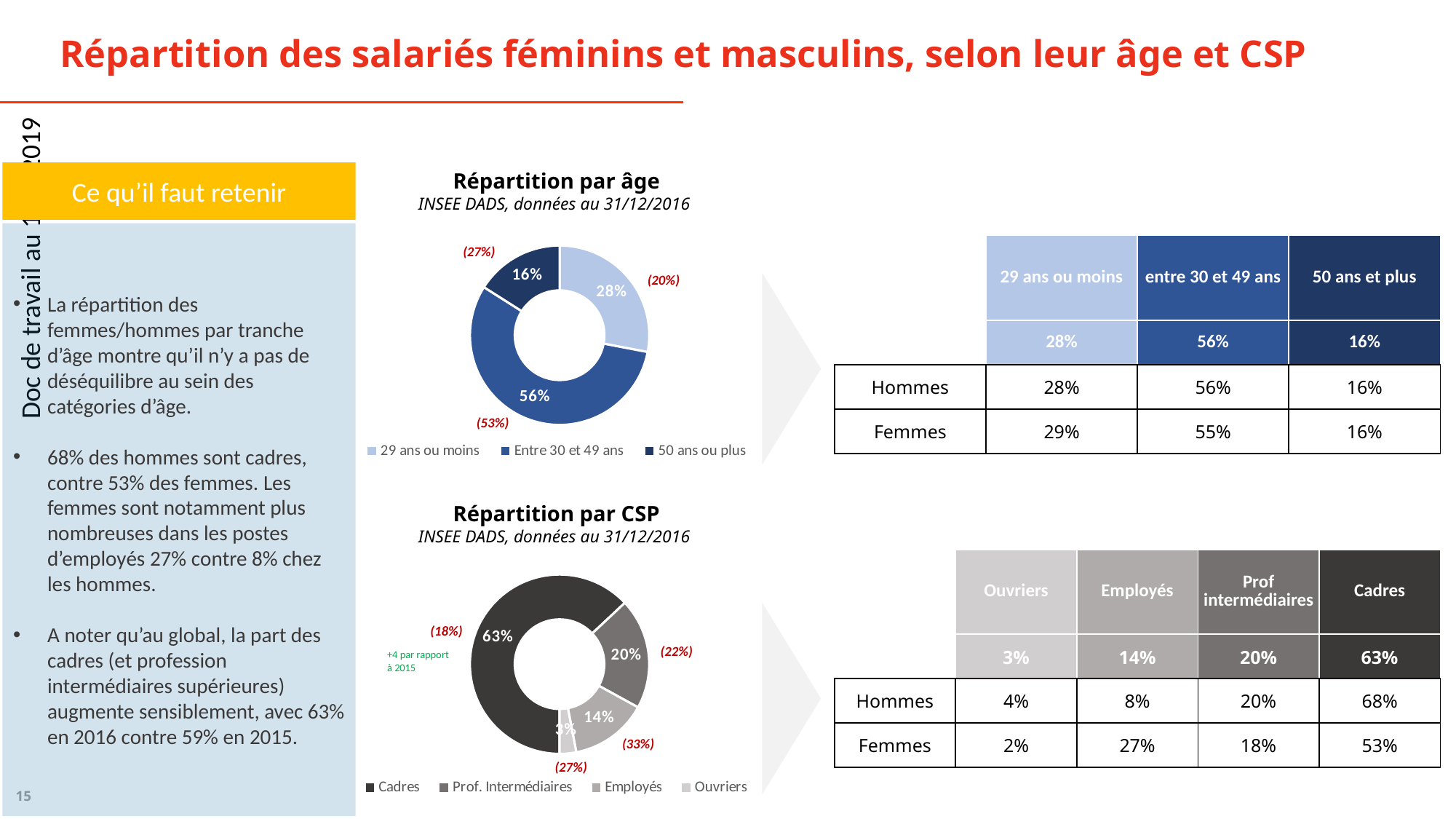
In the 'Répartition par CSP' chart, which category has the smallest share? Ouvriers In the 'Répartition par CSP' chart, what share is shown for 'Employés'? 14% In the 'Répartition par CSP' chart, which is larger: the share for 'Prof. Intermédiaires' or for 'Employés'? Prof. Intermédiaires In the 'Répartition par âge' chart, which age group has the smallest share? 50 ans ou plus How many categories does the legend of the 'Répartition par CSP' chart list? 4 How many categories does the legend of the 'Répartition par âge' chart list? 3 In the 'Répartition par CSP' chart, what share is shown for 'Cadres'? 63% In the 'Répartition par âge' chart, what share is shown for '50 ans ou plus'? 16% What type of chart is 'Répartition par CSP'? Doughnut chart In the 'Répartition par âge' chart, what share is shown for 'Entre 30 et 49 ans'? 56% In the 'Répartition par âge' chart, what is the difference between the shares for '29 ans ou moins' and '50 ans ou plus'? 12% In the 'Répartition par âge' chart, which age group has the largest share? Entre 30 et 49 ans